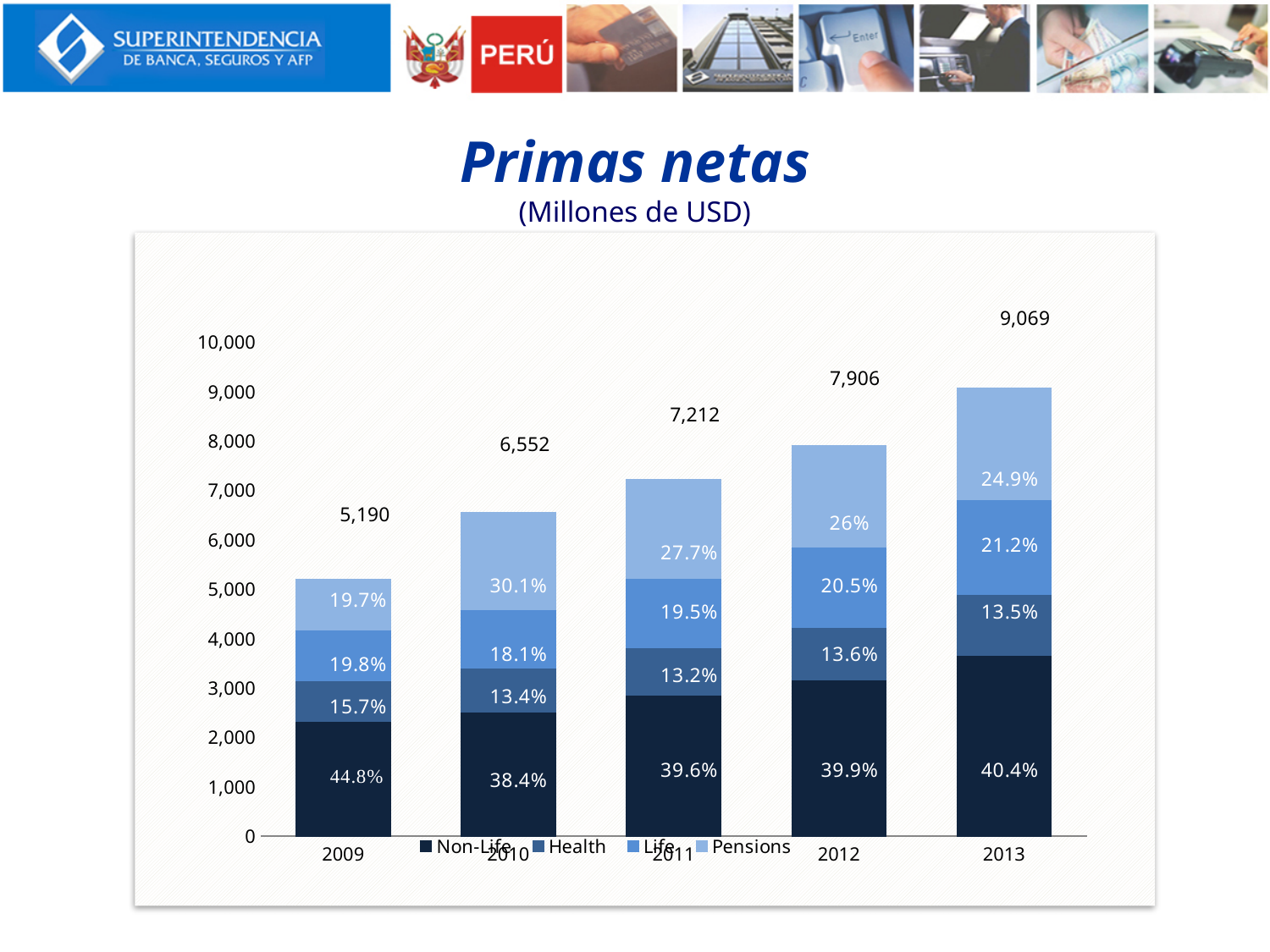
How many series does the legend list? 4 What is the difference between the total for 2013 and the total for 2009? 3,879 What is the total net premiums value shown above the bar for 2013? 9,069 What is the total value labelled above the 2009 bar? 5,190 What percentage is shown for the Health segment in 2013? 13.5% What percentage share does the Non-Life segment have in the 2009 bar? 44.8% Do the total net premiums rise or fall from 2009 to 2013? rise What percentage is shown for the Pensions segment in 2010? 30.1% Which year has the lowest total net premiums? 2009 Which year has the highest total net premiums? 2013 How many years are shown on the x axis? 5 Which is larger, the total for 2011 or the total for 2012? 2012